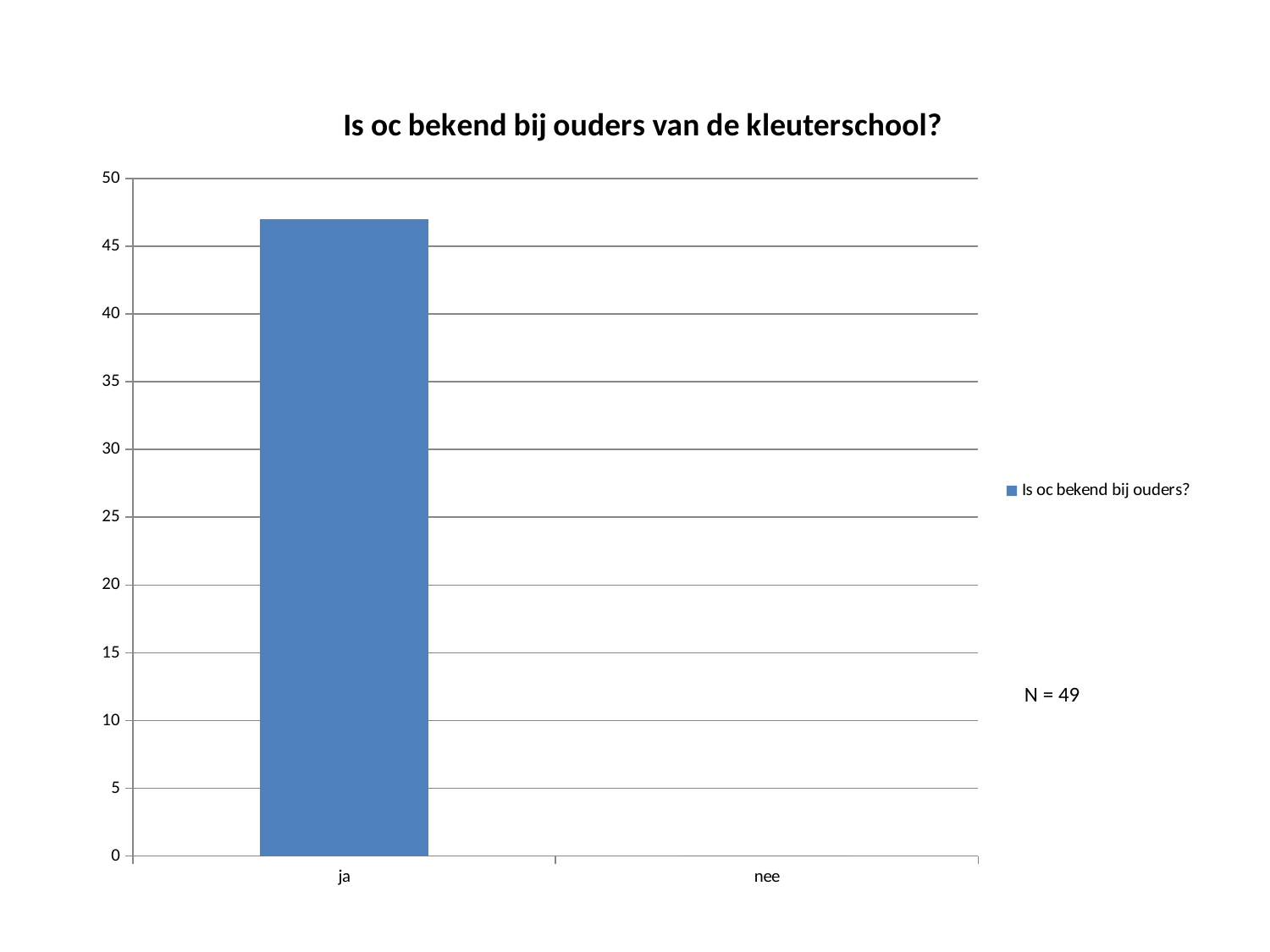
What is the name of the series listed in the legend? Is oc bekend bij ouders? How many categories are shown on the x axis of the chart? 2 What is the highest value shown on the y axis? 50 What kind of chart is shown on the slide? bar chart Is the value for ja greater or less than 45? greater How many series does the legend list? 1 Is the value for ja greater or less than 50? less Which category has the highest value? ja Is the value for nee greater or less than 5? less What is the title of the chart? Is oc bekend bij ouders van de kleuterschool? Which is larger, the value for ja or the value for nee? ja Which category has the lowest value? nee